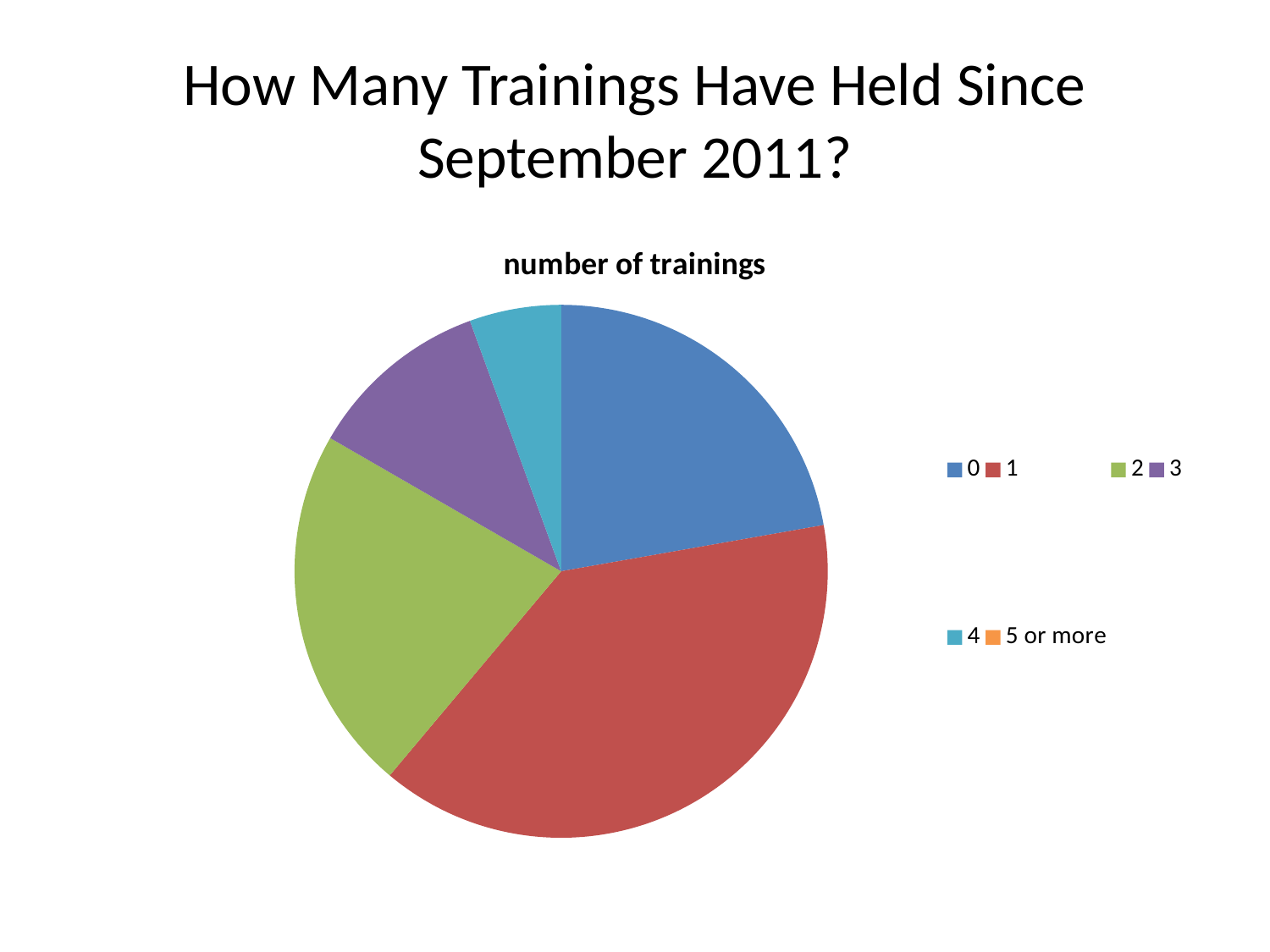
Which slice is larger, the one for 2 or the one for 4? 2 What kind of chart is shown on the slide? pie chart Which slice is larger, the one for 1 or the one for 0? 1 Which legend category has no visible slice in the pie? 5 or more How many categories does the legend list? 6 Which slice is larger, the one for 0 or the one for 3? 0 Does the slice for 1 take up more or less than half of the pie? less What is the title of the chart? number of trainings Which category has the largest slice of the pie? 1